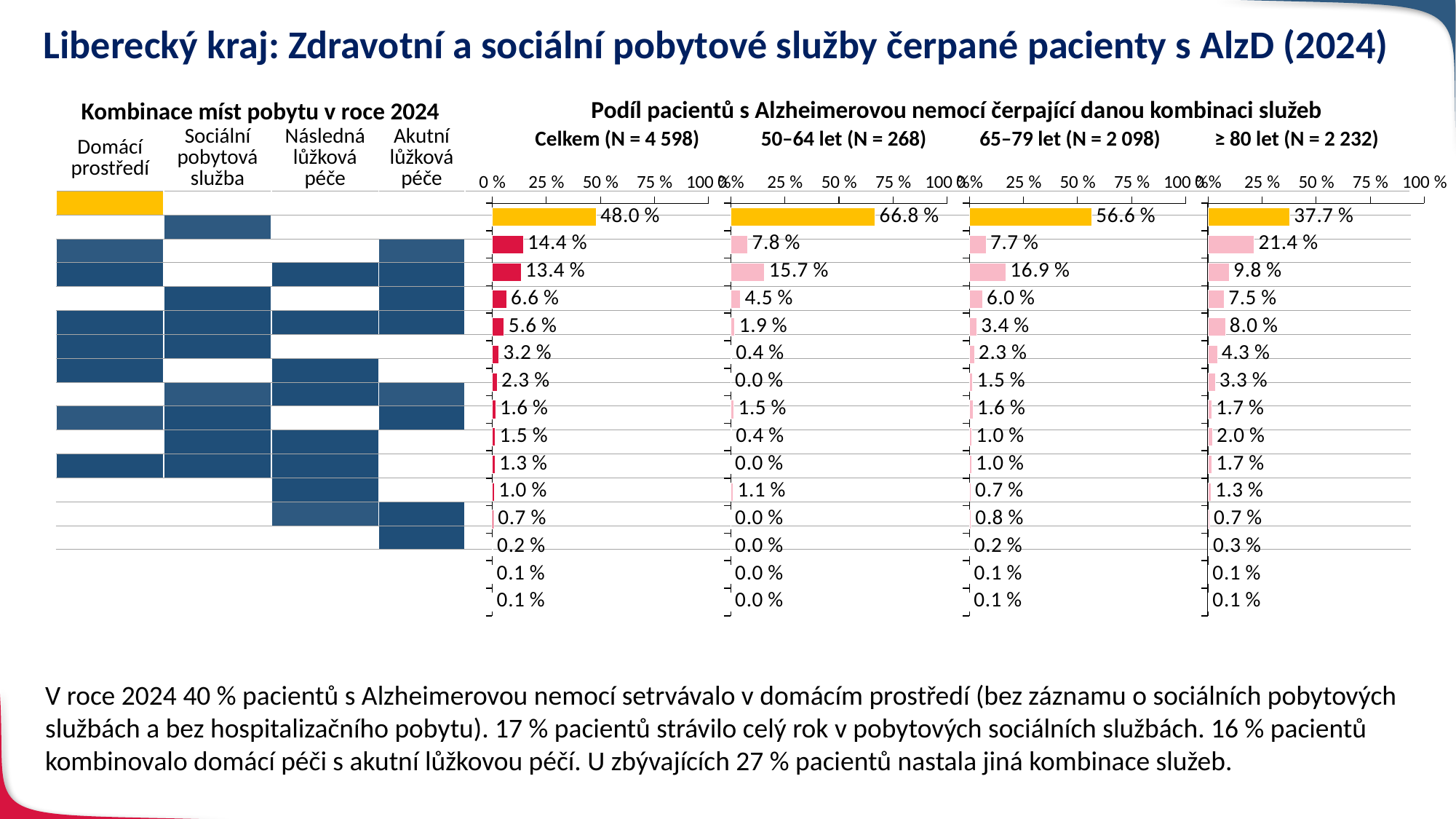
In the '50–64 let (N = 268)' chart, what is the value of the top (yellow) bar? 66.8 % In the '≥ 80 let (N = 2 232)' chart, what is the value of the second bar from the top (Sociální pobytová služba only)? 21.4 % How many bars (combinations of places of stay) does each of the four charts show? 15 In the 'Celkem (N = 4 598)' chart, what is the value of the bottom bar? 0.1 % What kind of chart is used to show the share of patients for each combination of services? bar chart What is the N (number of patients) given in the heading of the 'Celkem' chart? 4 598 In the '≥ 80 let (N = 2 232)' chart, is the value of the top (yellow) bar greater or less than 25 %? greater In the '65–79 let (N = 2 098)' chart, which is larger: the second bar from the top (7.7 %) or the third bar from the top (16.9 %)? the third bar, 16.9 % In the 'Celkem (N = 4 598)' chart, what is the value of the top (yellow) bar, for patients staying only in the home environment (Domácí prostředí)? 48.0 % In the '65–79 let (N = 2 098)' chart, what is the value of the top (yellow) bar? 56.6 % Across the three age-group charts, which age group has the highest value for the top (yellow) bar? 50–64 let In the 'Celkem (N = 4 598)' chart, what is the difference between the top bar (48.0 %) and the second bar (14.4 %)? 33.6 %